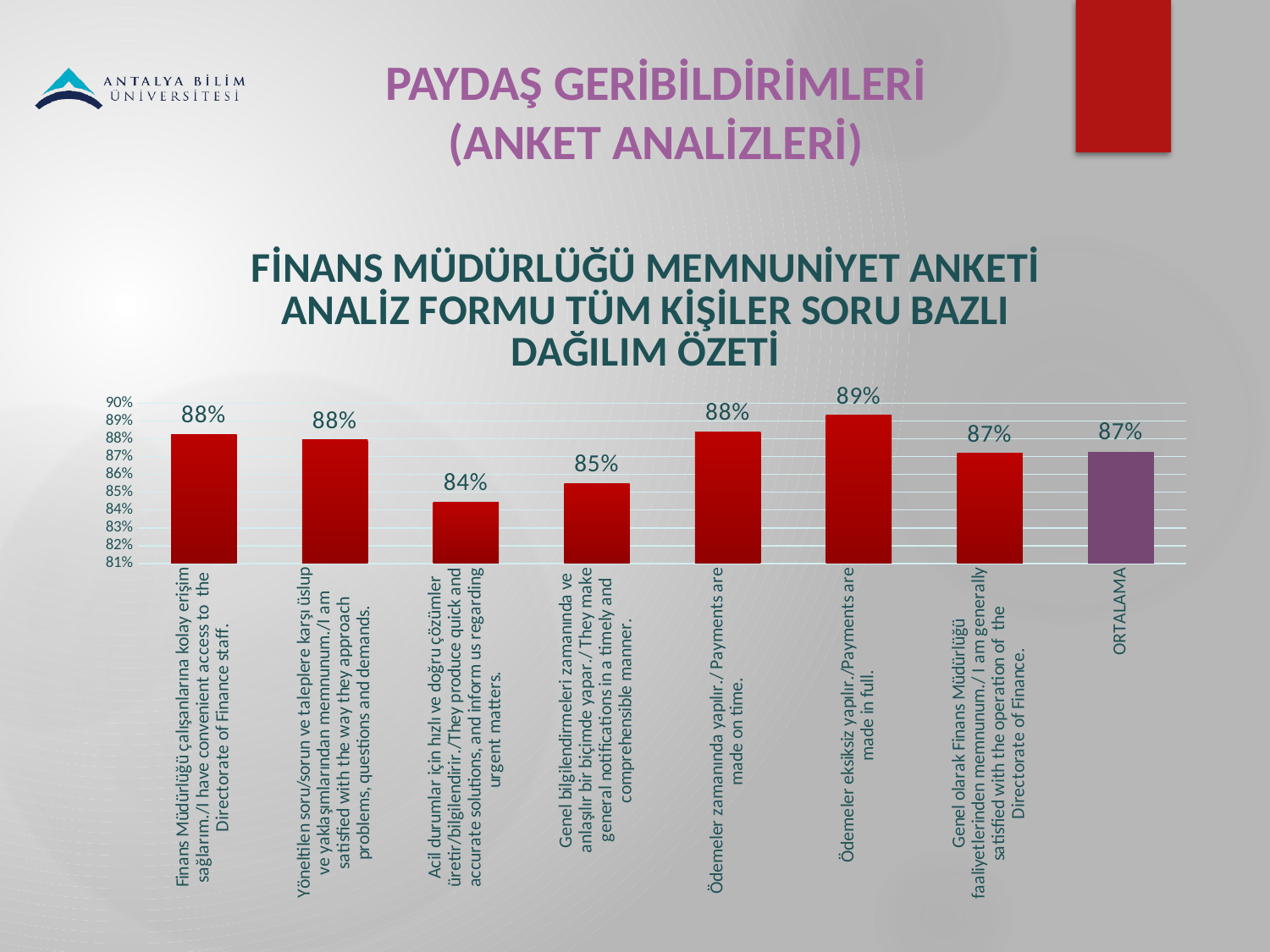
Which category has the highest value? Ödemeler eksiksiz yapılır./Payments are made in full. What is the value for "They produce quick and accurate solutions, and inform us regarding urgent matters"? 84% What colour is the ORTALAMA bar, compared with the other bars? purple (the others are red) What is the value for "Payments are made on time" (Ödemeler zamanında yapılır)? 88% What is the value for ORTALAMA? 87% What is the value for "Payments are made in full" (Ödemeler eksiksiz yapılır)? 89% Which is larger: the value for "Payments are made on time" or the value for "They make general notifications in a timely and comprehensible manner"? Payments are made on time What kind of chart is shown on the slide? bar chart What is the difference between the highest value (89%) and the lowest value (84%)? 5 percentage points How many bars are plotted in the chart? 8 Which category has the lowest value? Acil durumlar için hızlı ve doğru çözümler üretir/bilgilendirir./They produce quick and accurate solutions, and inform us regarding urgent matters. Is the value for ORTALAMA greater or less than 85%? greater